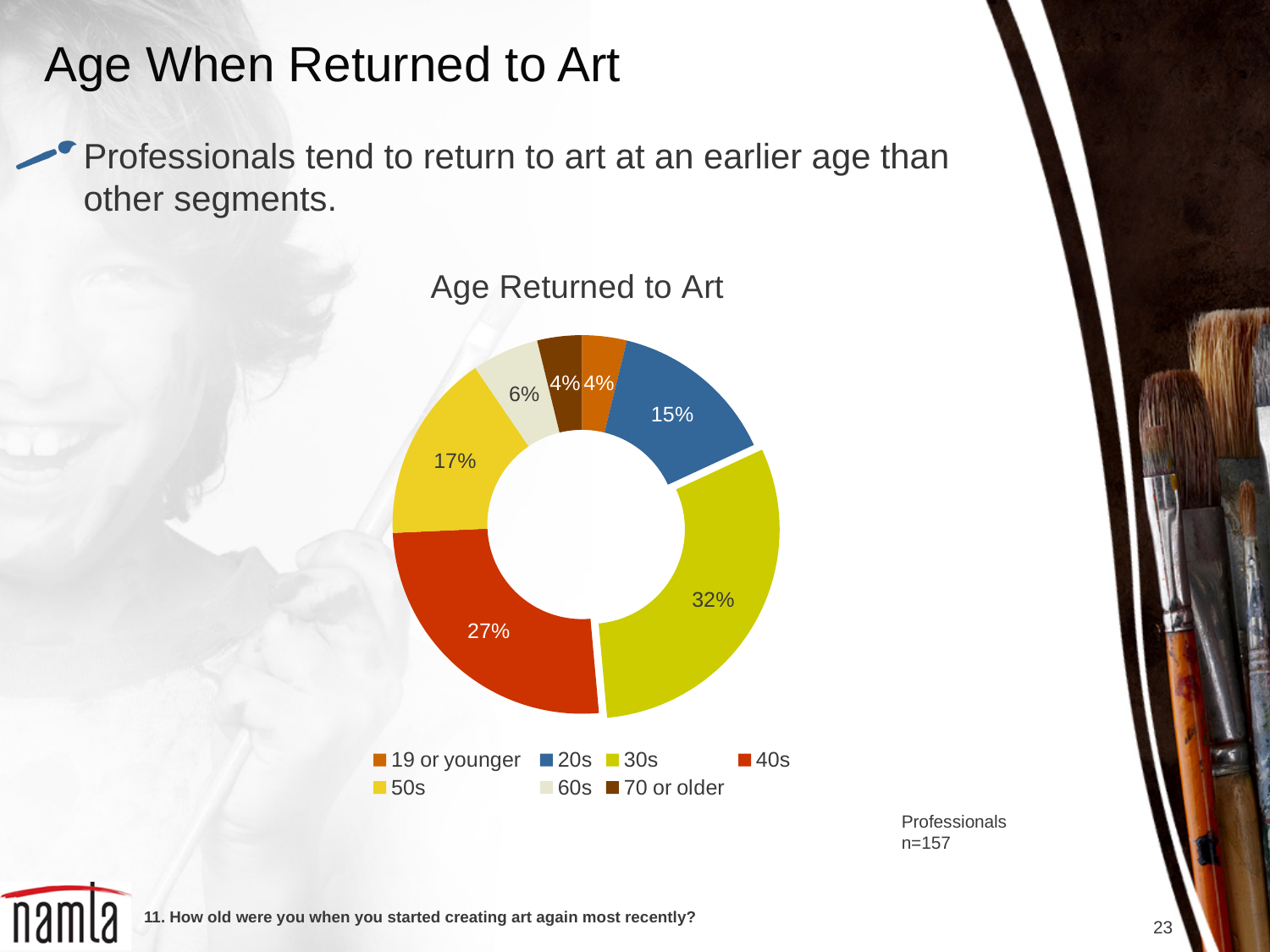
How many age categories does the legend list? 7 What percentage of professionals returned to art in their 20s? 15% What is the sample size (n) noted for Professionals on the slide? n=157 What kind of chart is shown on the slide? Doughnut (pie) chart What is the difference in percentage points between the 30s and 40s slices? 5 What percentage of professionals returned to art in their 60s? 6% What is the combined share of the 19 or younger and 70 or older slices? 8% Which is larger, the share for 50s or the share for 20s? 50s Which age group has the largest share of the chart? 30s What percentage of professionals returned to art in their 40s? 27% What percentage of professionals returned to art in their 30s? 32% What is the title of the chart? Age Returned to Art